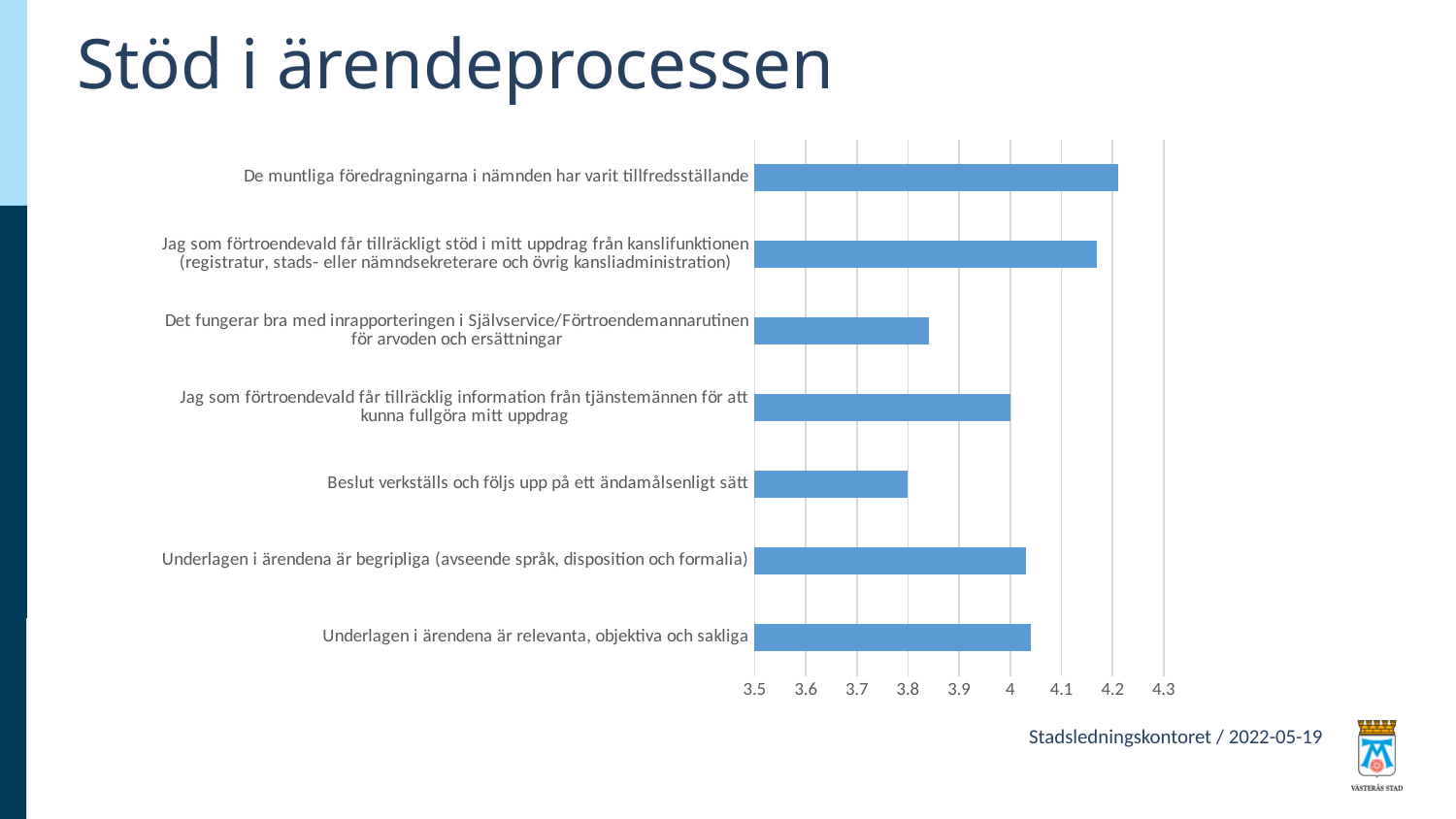
Which has a larger value: 'De muntliga föredragningarna i nämnden har varit tillfredsställande' or 'Det fungerar bra med inrapporteringen i Självservice/Förtroendemannarutinen för arvoden och ersättningar'? De muntliga föredragningarna i nämnden har varit tillfredsställande Which category has the lowest value? Beslut verkställs och följs upp på ett ändamålsenligt sätt Which has a larger value: 'Beslut verkställs och följs upp på ett ändamålsenligt sätt' or 'Underlagen i ärendena är begripliga (avseende språk, disposition och formalia)'? Underlagen i ärendena är begripliga (avseende språk, disposition och formalia) Which category has the highest value? De muntliga föredragningarna i nämnden har varit tillfredsställande Is the value for 'Det fungerar bra med inrapporteringen i Självservice/Förtroendemannarutinen för arvoden och ersättningar' greater or less than 3.9? less Is the value for 'Underlagen i ärendena är relevanta, objektiva och sakliga' greater or less than 4? greater What is the value for 'Jag som förtroendevald får tillräcklig information från tjänstemännen för att kunna fullgöra mitt uppdrag'? 4 What kind of chart is shown on the slide? bar chart How many categories (bars) does the chart show? 7 What is the title of the slide containing the chart? Stöd i ärendeprocessen Is the value for 'Jag som förtroendevald får tillräckligt stöd i mitt uppdrag från kanslifunktionen' greater or less than 4.1? greater